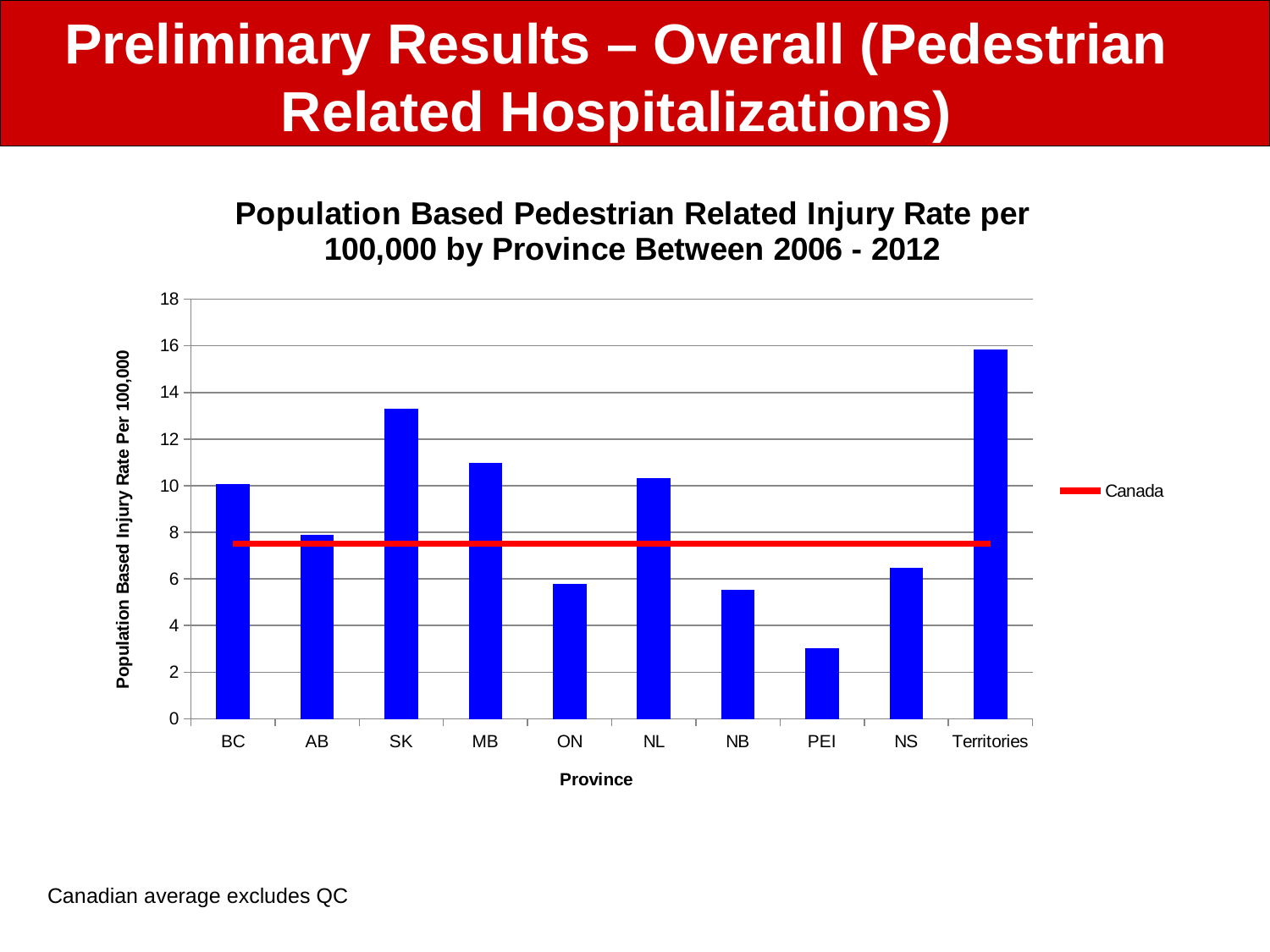
Is the value for Territories greater or less than 14? greater How many entries does the legend list? 1 Is the value for PEI greater or less than 4? less What does the red horizontal line represent according to the legend? Canada Which has a higher injury rate, SK or MB? SK How many provinces/regions are shown on the x axis? 10 Is the value for NB greater or less than 8? less Which has a higher injury rate, NS or PEI? NS What kind of chart is shown on the slide? bar chart Which province has the lowest population based pedestrian related injury rate? PEI Which province has the highest population based pedestrian related injury rate? Territories